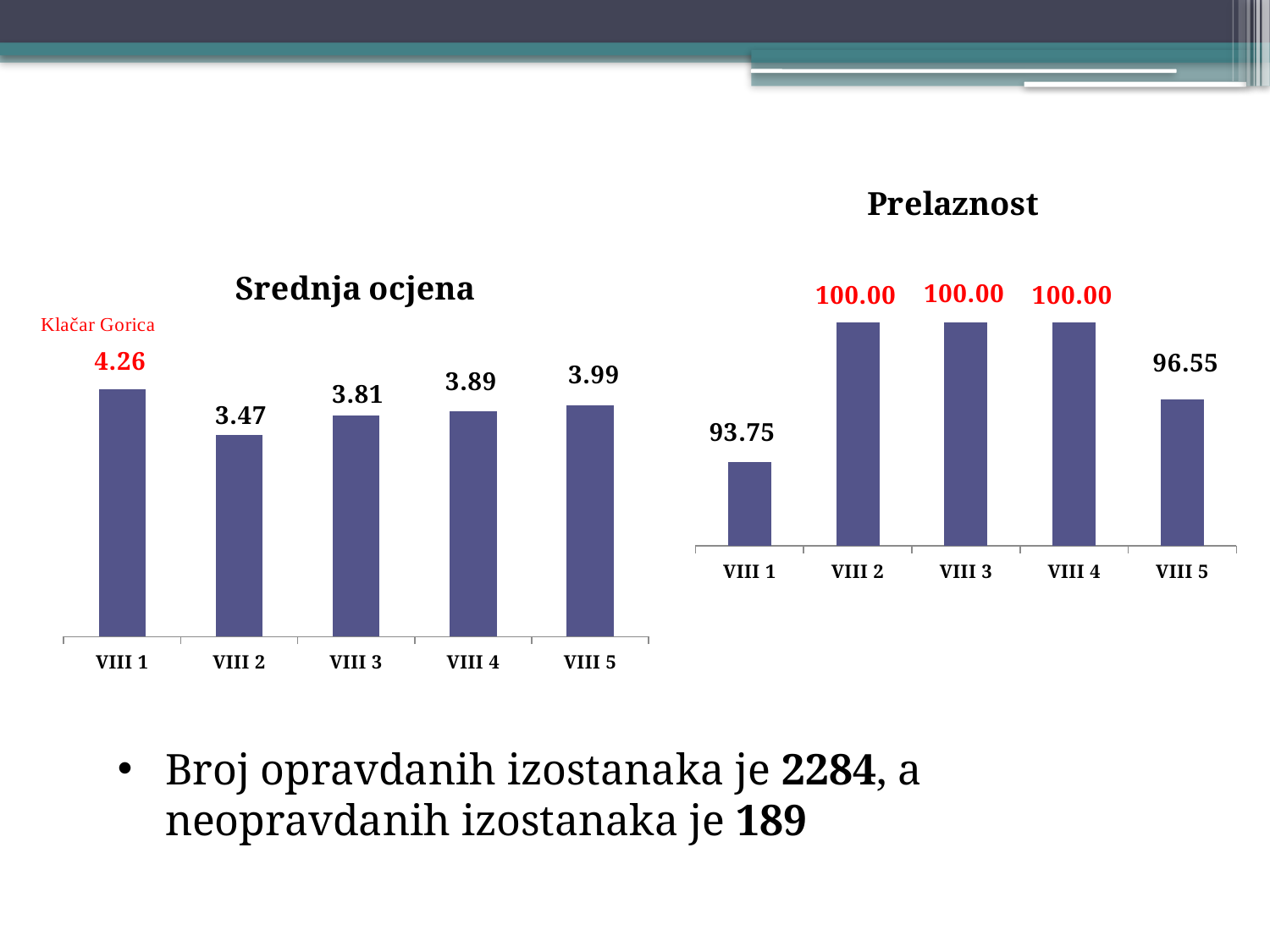
In the 'Srednja ocjena' chart, which is larger, the value for VIII 4 or VIII 5? VIII 5 In the 'Srednja ocjena' chart, which category has the lowest value? VIII 2 In the 'Prelaznost' chart, which category has the lowest value? VIII 1 In the 'Srednja ocjena' chart, what is the value for VIII 1? 4.26 In the 'Srednja ocjena' chart, which category has the highest value? VIII 1 In the 'Prelaznost' chart, what is the value for VIII 1? 93.75 In the 'Srednja ocjena' chart, what is the value for VIII 3? 3.81 How many categories are shown in the 'Prelaznost' chart? 5 In the 'Prelaznost' chart, what is the difference between the values for VIII 2 and VIII 1? 6.25 In the 'Srednja ocjena' chart, what is the difference between the values for VIII 1 and VIII 2? 0.79 What type of chart is the 'Srednja ocjena' chart? Bar chart In the 'Prelaznost' chart, what is the value for VIII 5? 96.55